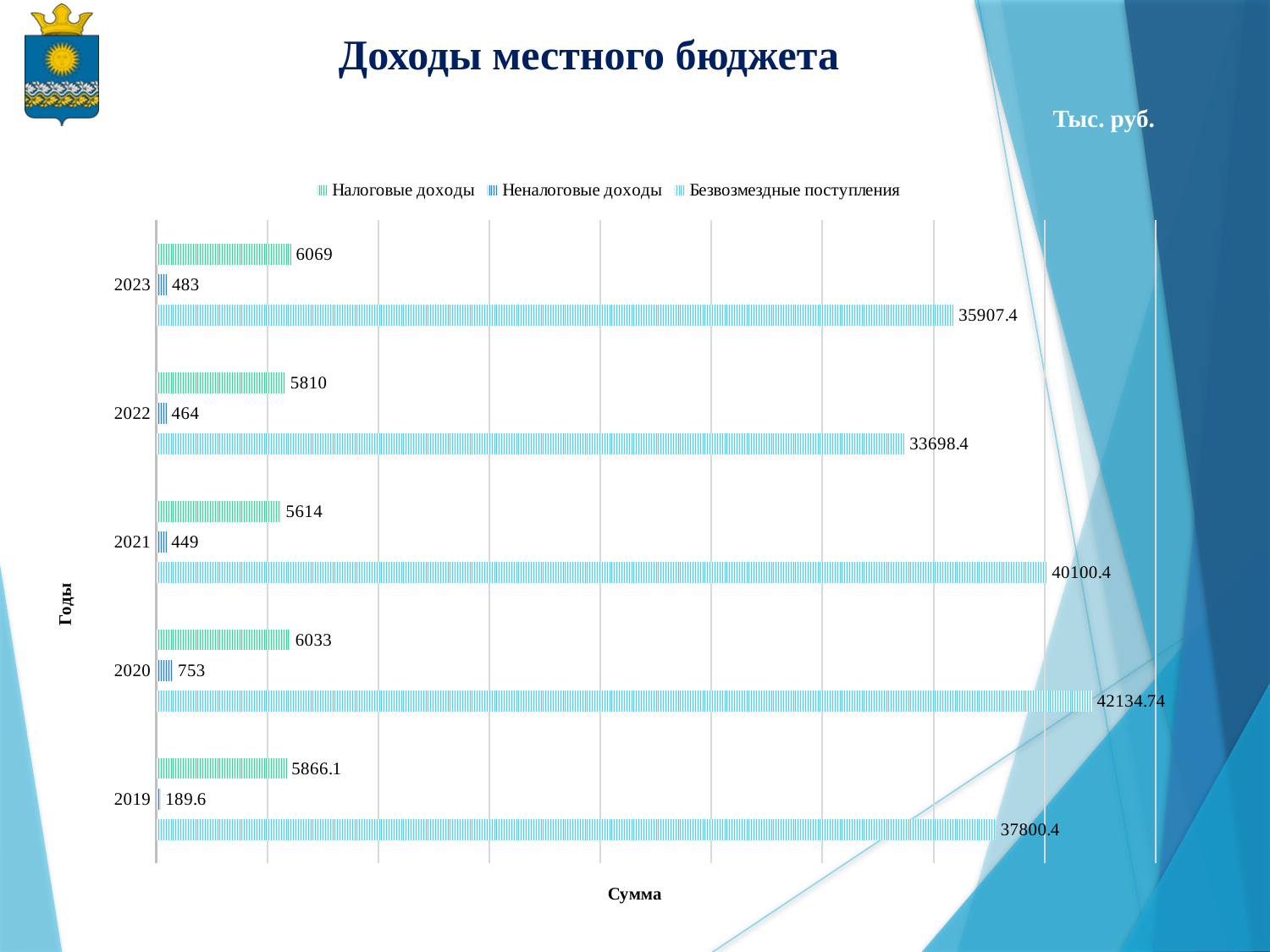
How many years are shown on the chart? 5 How many series does the legend list? 3 What is the value of Неналоговые доходы for 2020? 753 In which year were Безвозмездные поступления the highest? 2020 In which year were Неналоговые доходы the lowest? 2019 What is the difference between Налоговые доходы in 2023 and in 2022? 259 What is the title of the slide? Доходы местного бюджета Which year had larger Безвозмездные поступления, 2021 or 2022? 2021 What kind of chart is shown on the slide? Bar chart What is the value of Налоговые доходы for 2023? 6069 What is the value of Безвозмездные поступления for 2021? 40100.4 What is the difference between Безвозмездные поступления in 2020 and in 2019? 4334.34